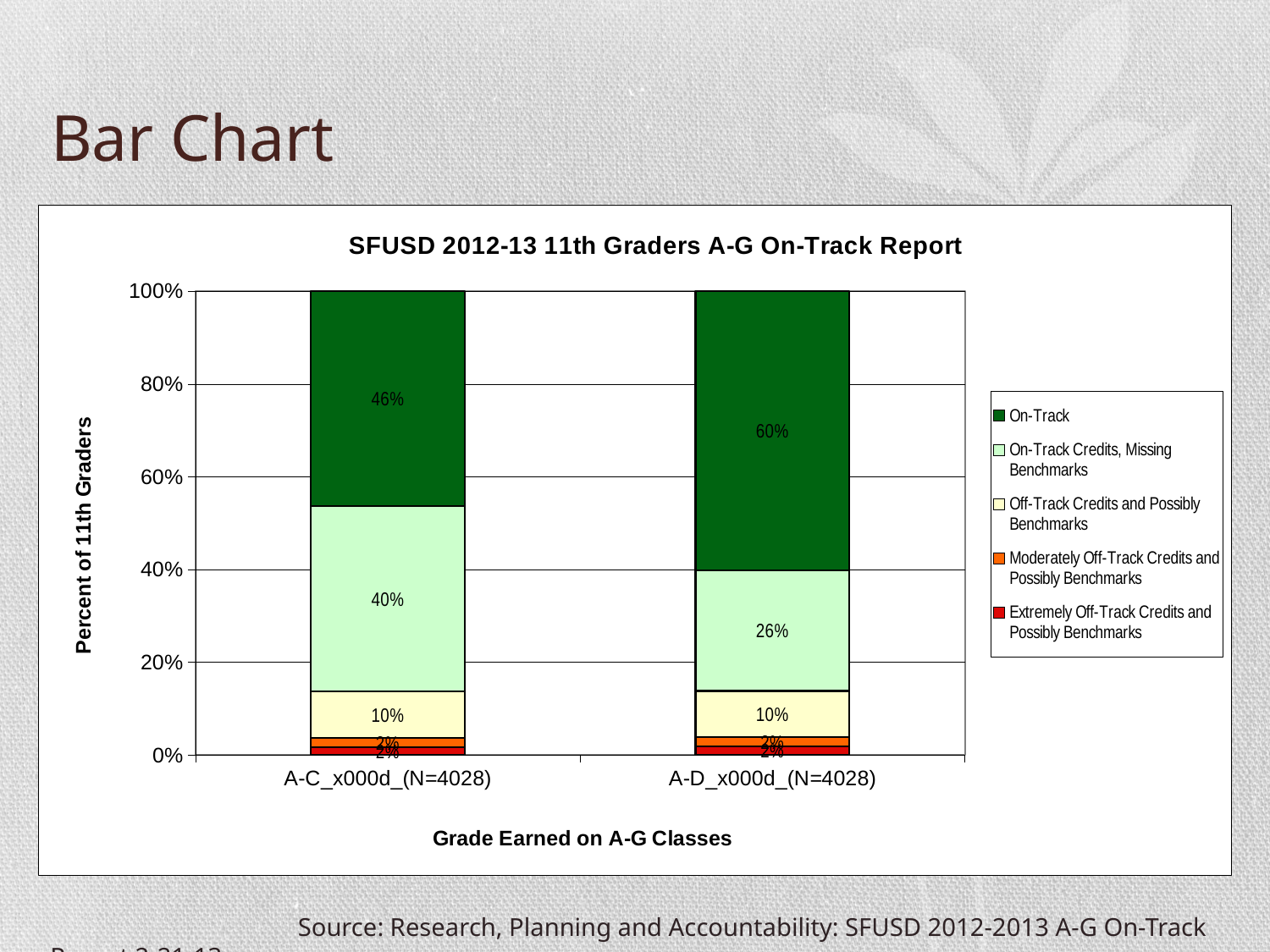
What kind of chart is shown on the slide? Stacked bar chart What is the label of the y axis? Percent of 11th Graders What is the value for Off-Track Credits and Possibly Benchmarks in the A-C (N=4028) bar? 10% What percentage of 11th graders are On-Track for the A-D (N=4028) category? 60% What is the title of the chart? SFUSD 2012-13 11th Graders A-G On-Track Report What percentage of 11th graders are On-Track for the A-C (N=4028) category? 46% What is the value for On-Track Credits, Missing Benchmarks in the A-D (N=4028) bar? 26% What is the difference between the On-Track Credits, Missing Benchmarks values for A-C (N=4028) and A-D (N=4028)? 14% How many series does the legend list? 5 Which category has the higher On-Track percentage, A-C (N=4028) or A-D (N=4028)? A-D (N=4028) What is the difference between the On-Track percentages for A-D (N=4028) and A-C (N=4028)? 14% How many bars (grade categories) are plotted on the x axis? 2